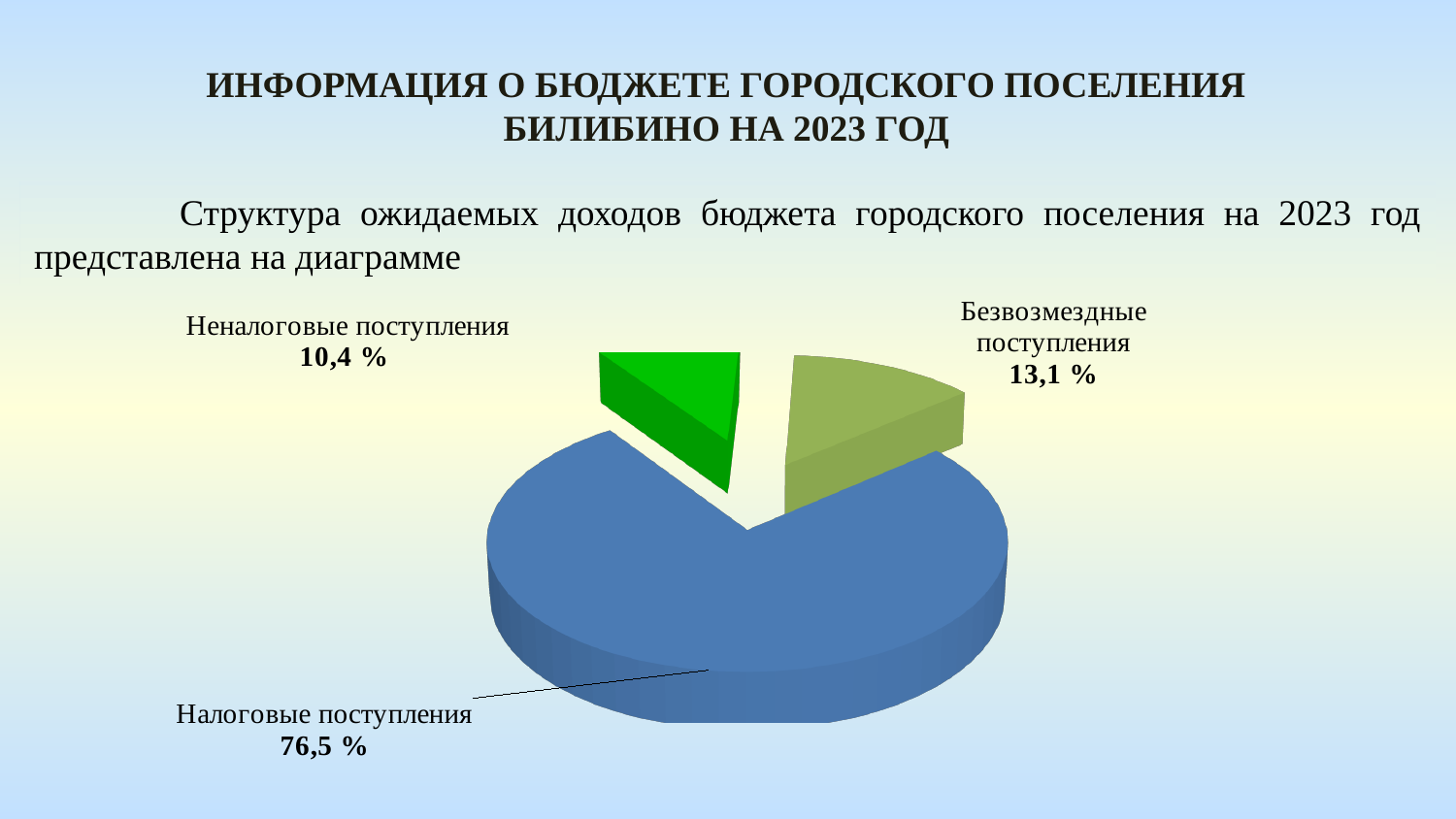
What share of the pie is Неналоговые поступления? 10,4 % Which is larger, Безвозмездные поступления or Неналоговые поступления? Безвозмездные поступления What share of the pie is Налоговые поступления? 76,5 % What is the difference in percentage points between Безвозмездные поступления and Неналоговые поступления? 2,7 What colour is the slice for Налоговые поступления? Blue What share of the pie is Безвозмездные поступления? 13,1 % What colour is the slice for Неналоговые поступления? Green What is the difference in percentage points between Налоговые поступления and Безвозмездные поступления? 63,4 What kind of chart is shown on the slide? Pie chart Which category has the largest slice of the pie? Налоговые поступления Which category has the smallest slice of the pie? Неналоговые поступления How many categories does the pie chart show? 3